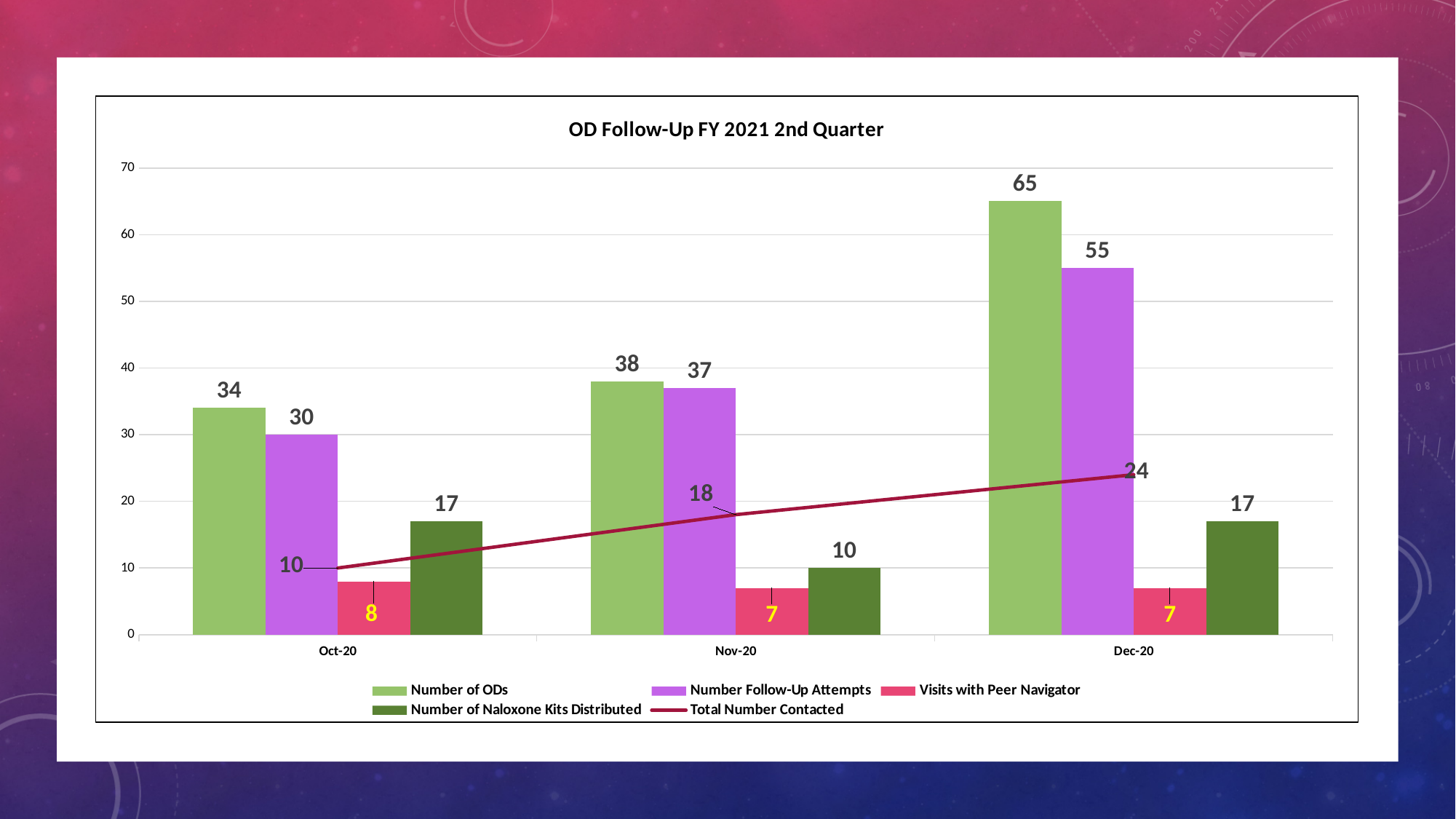
How many Visits with Peer Navigator were there in Oct-20? 8 What is the Number Follow-Up Attempts value for Nov-20? 37 How many months are shown on the x axis? 3 What is the difference between the Number of ODs and the Number Follow-Up Attempts in Dec-20? 10 Does the Total Number Contacted line rise or fall from Oct-20 to Dec-20? rise Which month has the highest Number of ODs? Dec-20 Which is larger in Oct-20: Number of Naloxone Kits Distributed or Visits with Peer Navigator? Number of Naloxone Kits Distributed How many series does the legend list? 5 Which month has the lowest Number of Naloxone Kits Distributed? Nov-20 What is the Total Number Contacted for Oct-20? 10 What is the title of the chart? OD Follow-Up FY 2021 2nd Quarter What is the Number of ODs for Dec-20? 65